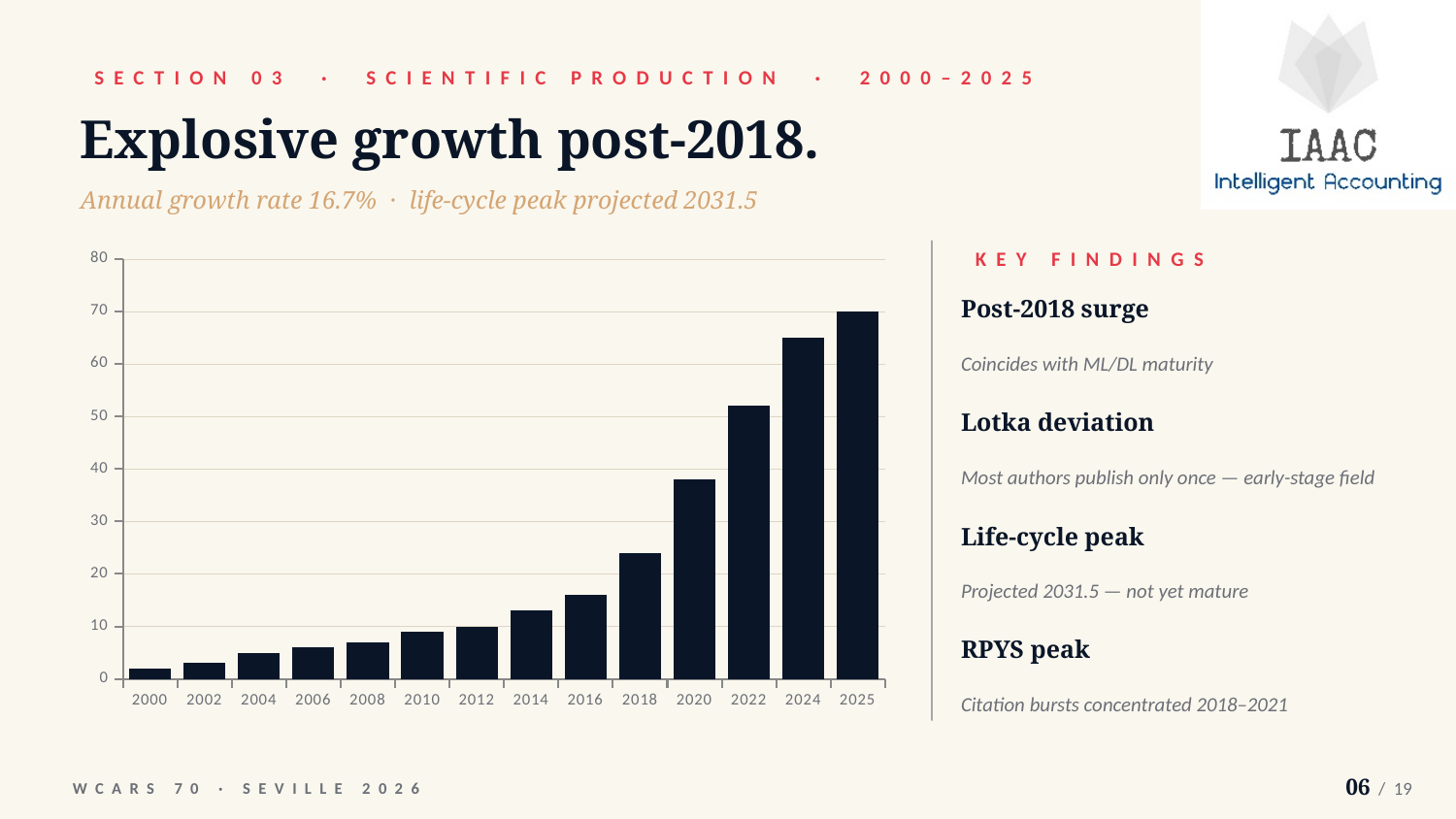
Is the value for 2020 greater or less than 30? greater Is the value for 2018 greater or less than 20? greater How many bars are plotted in the chart? 14 Is the value for 2024 greater or less than 60? greater Which year has the lowest bar in the chart? 2000 Which year has the highest bar in the chart? 2025 What kind of chart is shown on the slide? bar chart Which year has the larger value, 2014 or 2016? 2016 Do the values rise or fall from 2000 to 2025? rise What is the title of the slide containing the chart? Explosive growth post-2018.